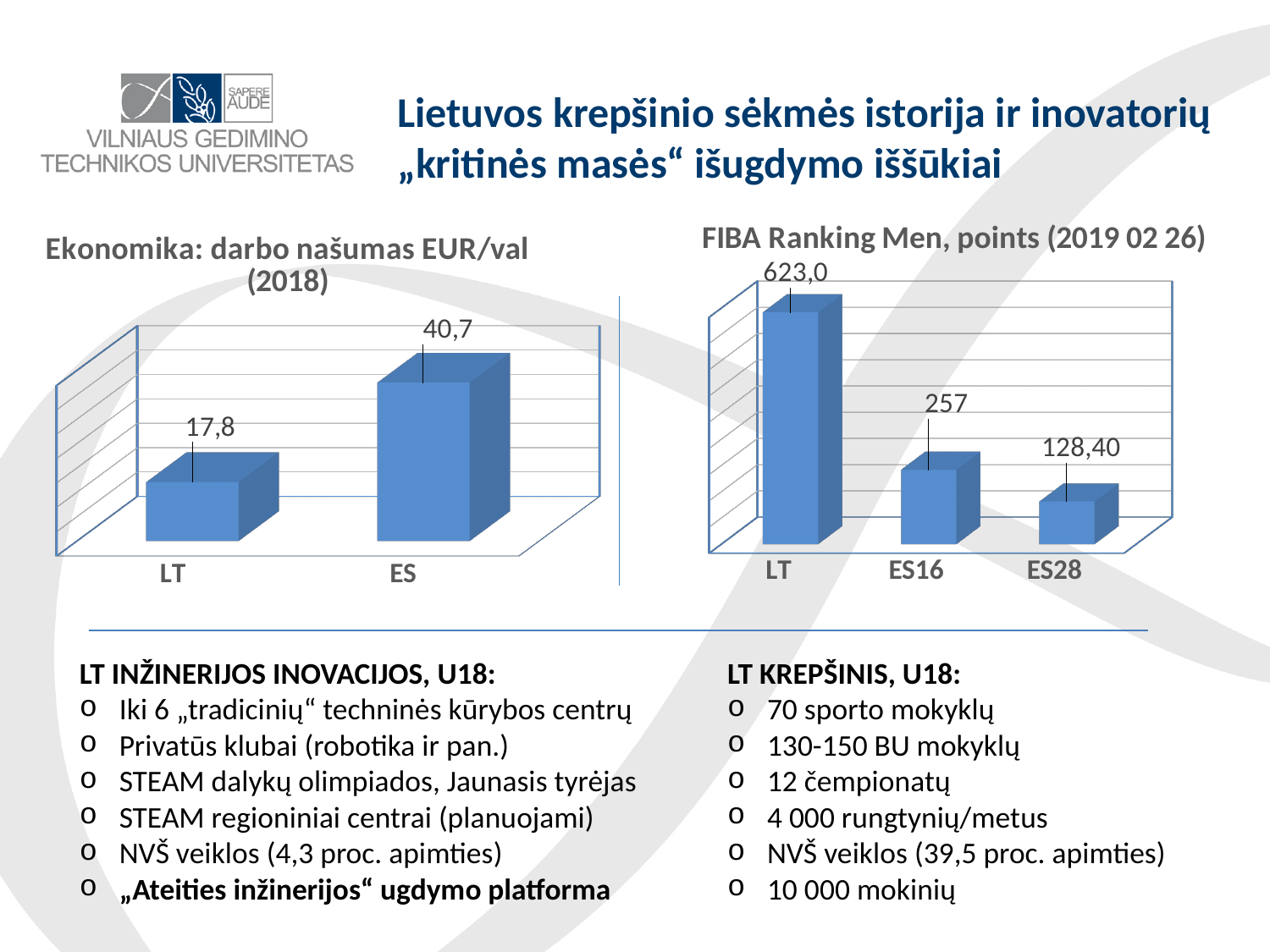
In the chart titled "Ekonomika: darbo našumas EUR/val (2018)", what is the value for ES? 40,7 In the chart titled "FIBA Ranking Men, points (2019 02 26)", which category has the lowest value? ES28 In the chart titled "FIBA Ranking Men, points (2019 02 26)", do the values rise or fall from left to right across the categories? fall In the chart titled "Ekonomika: darbo našumas EUR/val (2018)", which category has the higher value? ES In the chart titled "FIBA Ranking Men, points (2019 02 26)", what is the value for ES28? 128,40 In the chart titled "FIBA Ranking Men, points (2019 02 26)", is the value for ES16 larger or smaller than the value for ES28? larger In the chart titled "FIBA Ranking Men, points (2019 02 26)", what is the value for LT? 623,0 In the chart titled "Ekonomika: darbo našumas EUR/val (2018)", what is the difference between the ES and LT values? 22,9 In the chart titled "FIBA Ranking Men, points (2019 02 26)", what is the value for ES16? 257 In the chart titled "Ekonomika: darbo našumas EUR/val (2018)", what is the value for LT? 17,8 What kind of chart is the chart titled "FIBA Ranking Men, points (2019 02 26)"? bar chart How many categories are shown in the chart titled "Ekonomika: darbo našumas EUR/val (2018)"? 2